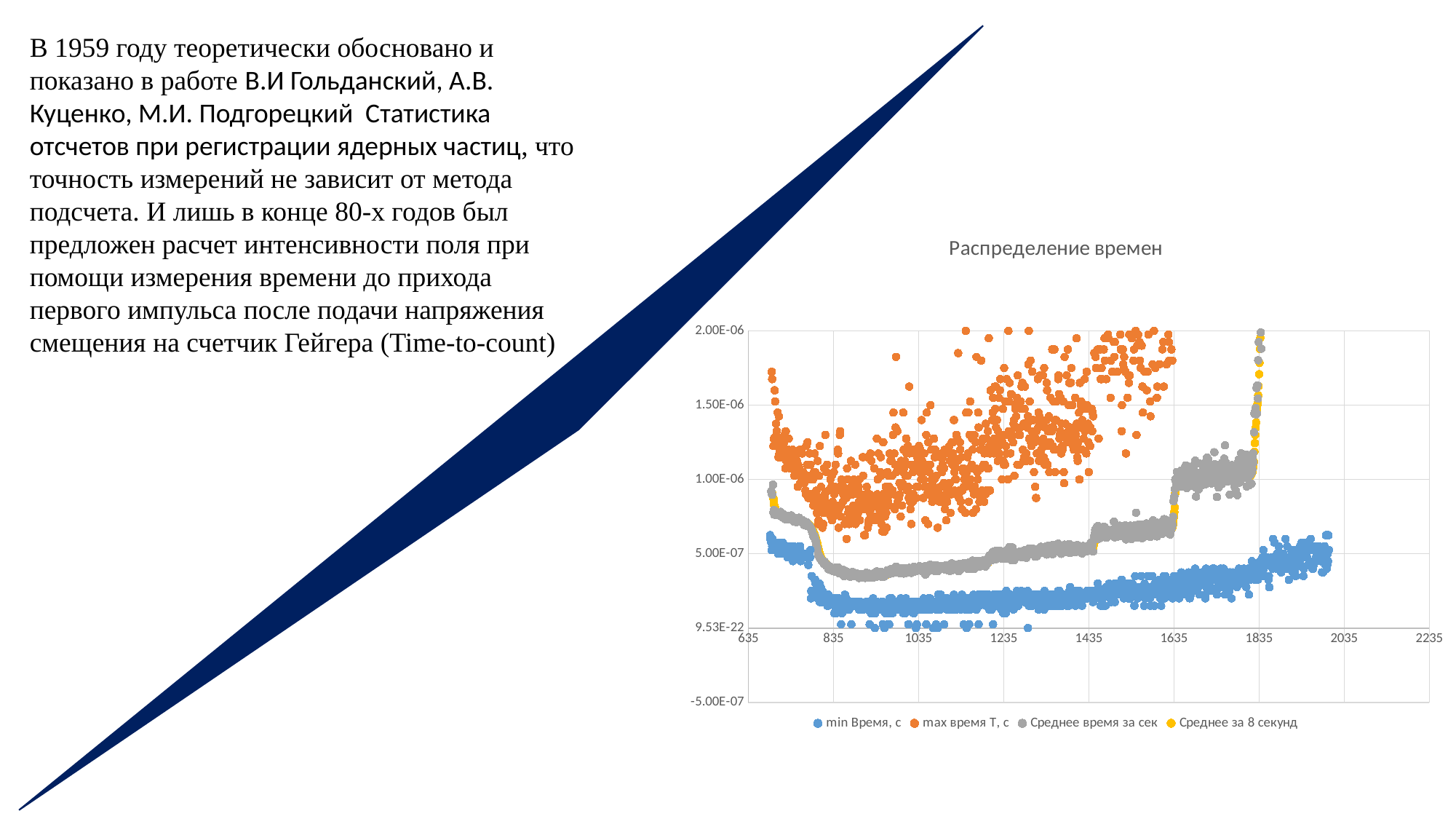
Which series generally has the higher values, "min Время, с" or "max время T, с"? max время T, с How many series does the chart legend list? 4 Is the value of the "Среднее время за сек" series at x = 1035 greater or less than 1.00E-06? less Which series has the lowest values across the chart? min Время, с What is the title of the chart? Распределение времен What is the highest value shown on the y axis of the chart? 2.00E-06 Do the values of the "Среднее время за сек" series rise or fall along the x axis between 1035 and 1835? rise What kind of chart is shown on the slide? scatter chart Is the value of the "Среднее время за сек" series at x = 1735 greater or less than 5.00E-07? greater Which series is shown in orange in the chart? max время T, с Is the value of the "min Время, с" series at x = 1235 greater or less than 5.00E-07? less